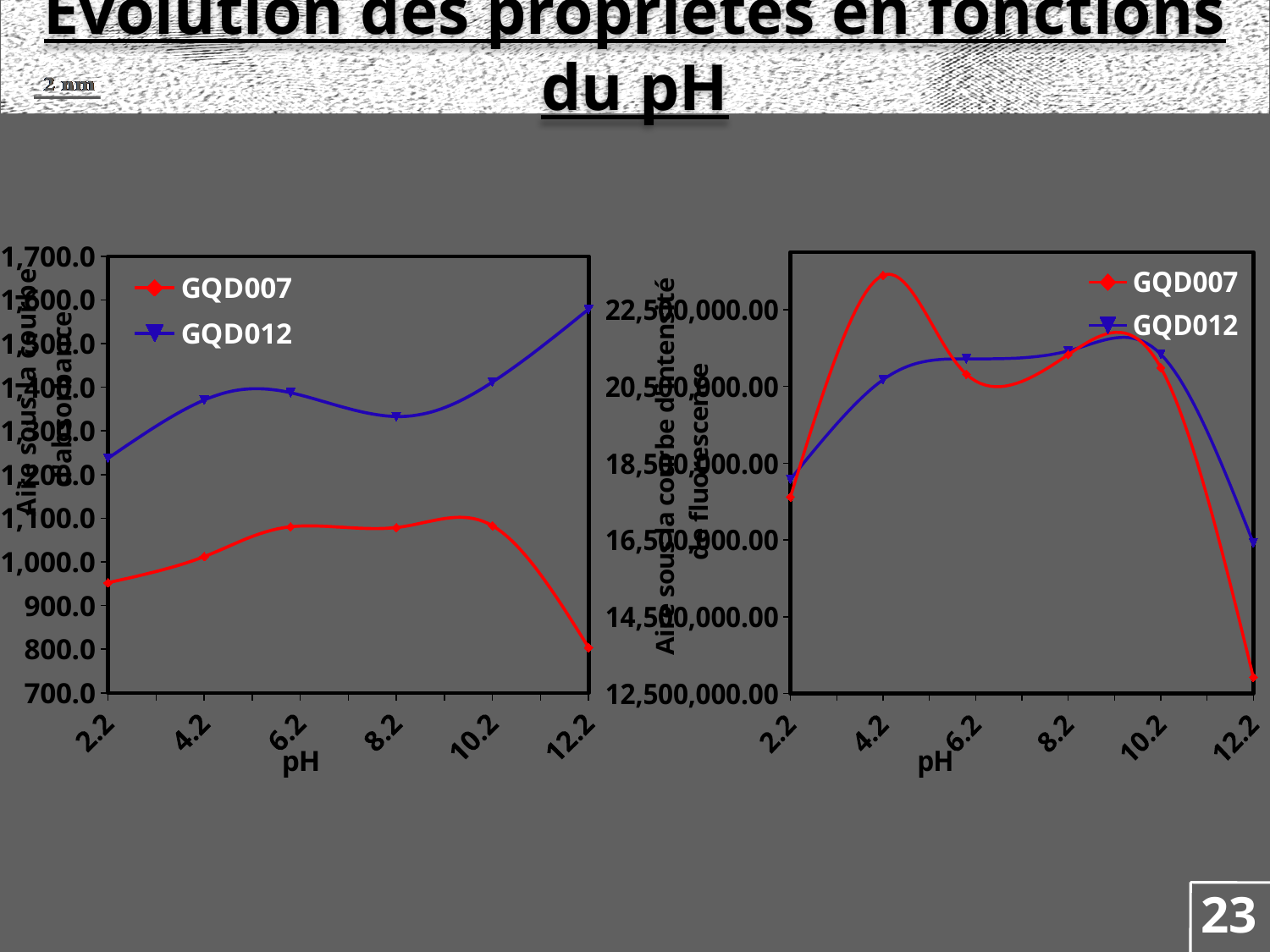
In the right chart, is the value of GQD007 at pH 12.2 greater or less than 14,500,000.00? less In the left chart, which series has the higher value at pH 12.2, GQD007 or GQD012? GQD012 In the right chart, is the value of GQD007 at pH 4.2 greater or less than 22,500,000.00? greater In the left chart, is the value of GQD012 at pH 8.2 greater or less than 1,300.0? greater In the right chart, at which pH does GQD007 reach its highest value? 4.2 In the right chart, which series has the higher value at pH 4.2, GQD007 or GQD012? GQD007 How many pH values are plotted along the x axis of the left chart? 6 In the left chart, at which pH does GQD012 reach its highest value? 12.2 How many series does the legend of the right chart (fluorescence intensity area vs pH) list? 2 What type of chart is the left chart (absorbance area vs pH)? line chart